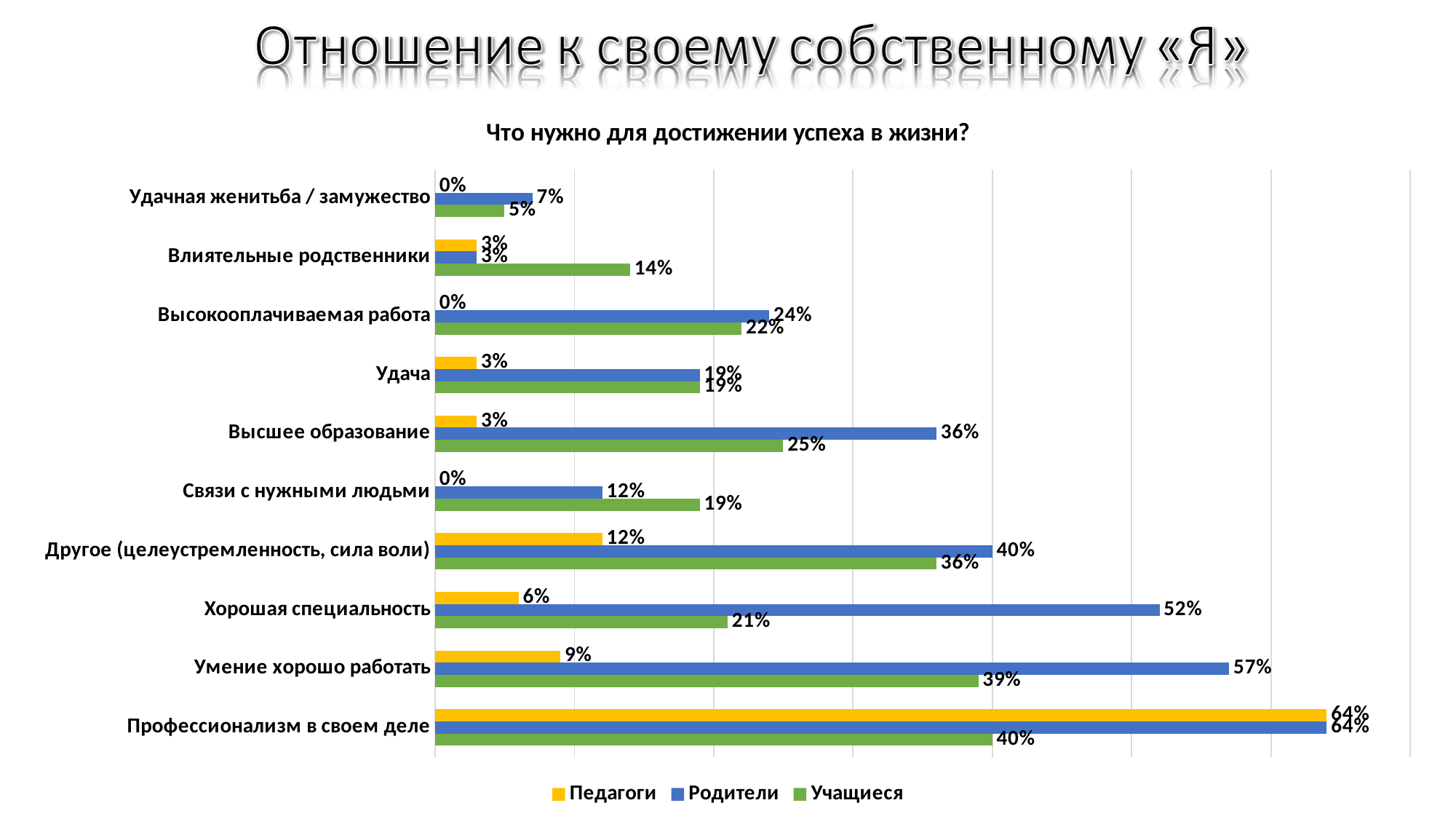
For Высшее образование, which is larger: the value for Родители or for Учащиеся? Родители Which category has the lowest value for Учащиеся? Удачная женитьба / замужество Which colour represents the series Учащиеся? green What is the value for Родители in the category Хорошая специальность? 52% Which category has the highest value for Родители? Профессионализм в своем деле What is the difference between the Родители and Учащиеся values for Умение хорошо работать? 18% What is the title of the chart? Что нужно для достижении успеха в жизни? How many series does the legend list? 3 How many categories are shown on the chart? 10 What kind of chart is shown on the slide? bar chart What is the value for Учащиеся in the category Влиятельные родственники? 14% What is the value for Педагоги in the category Профессионализм в своем деле? 64%